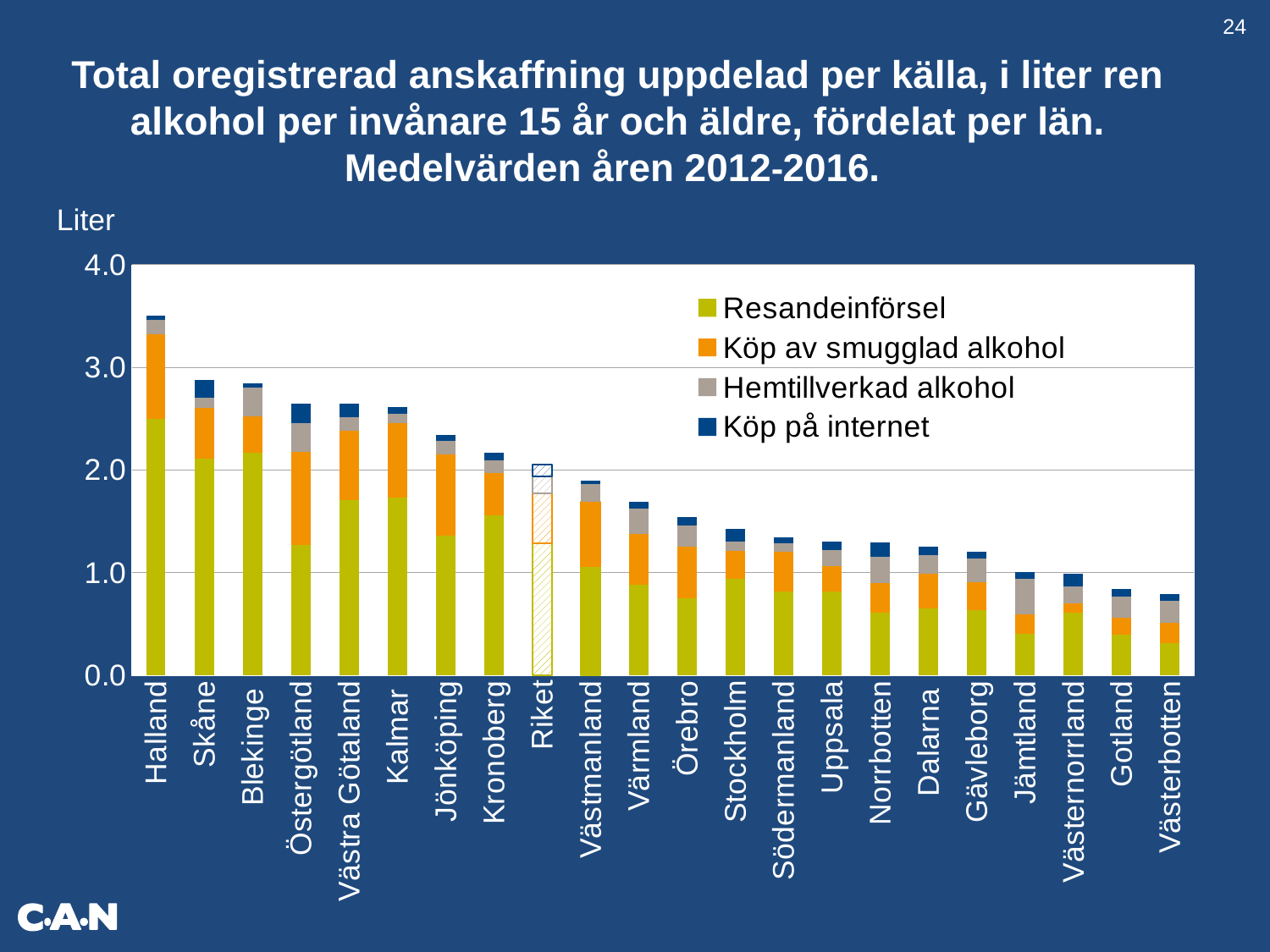
How many categories are shown along the x axis? 22 How many series does the legend list? 4 Is the total value for Halland greater or less than 3.0? greater What kind of chart is shown on the slide? Stacked bar chart Which has the larger total bar, Blekinge or Örebro? Blekinge Do the total bar values rise or fall from left to right along the x axis? fall Is the total value for Skåne greater or less than 3.0? less Is the total value for Gotland greater or less than 1.0? less Which category has the highest total bar? Halland Which legend entry is shown in orange? Köp av smugglad alkohol Which category has the lowest total bar? Västerbotten